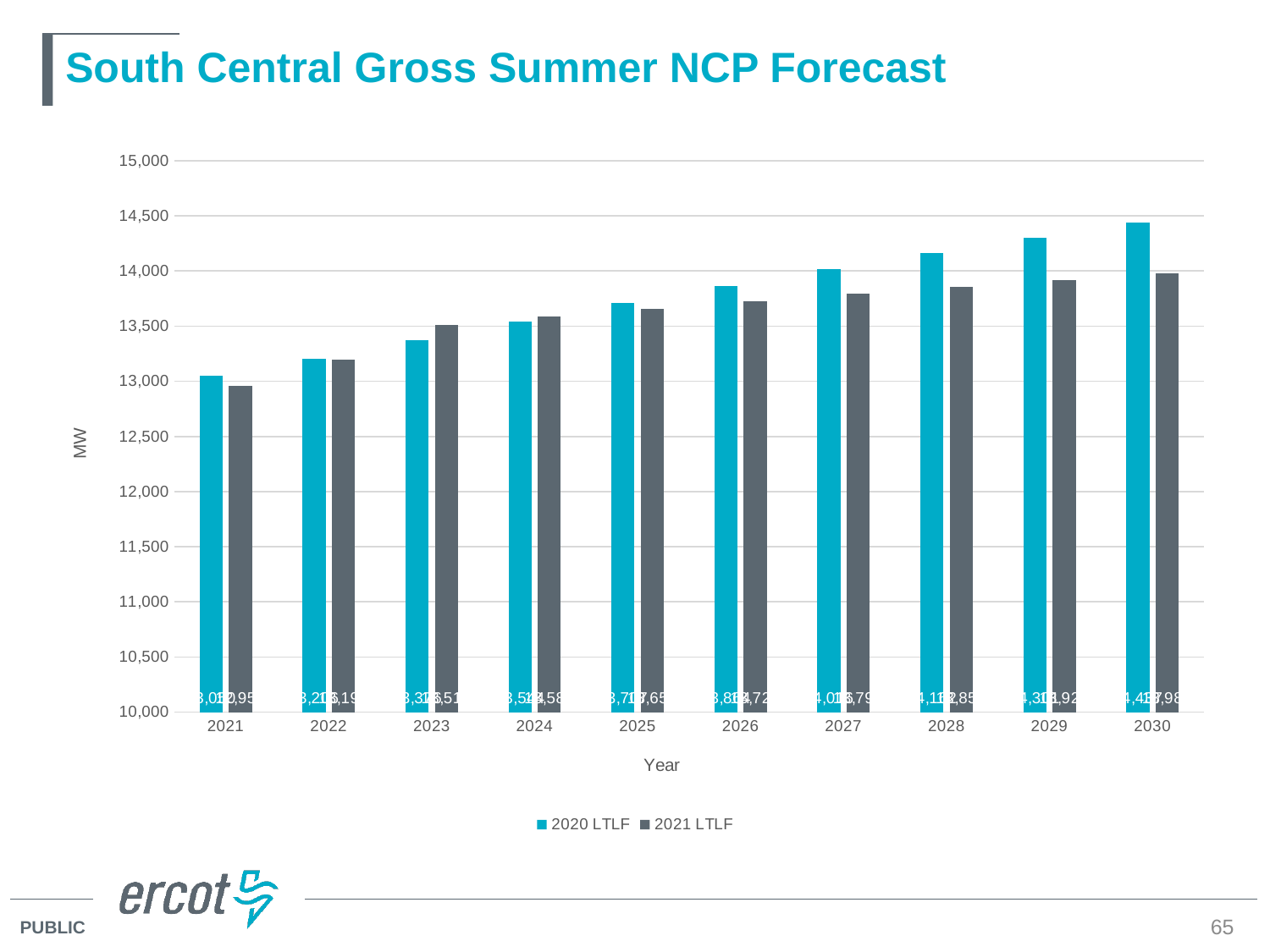
Which year has the lowest 2021 LTLF value? 2021 What is the label on the y axis? MW How many years are shown on the x axis? 10 Which year has the highest 2020 LTLF value? 2030 In 2023, which series has the larger value, 2020 LTLF or 2021 LTLF? 2021 LTLF How many series does the legend list? 2 Is the 2020 LTLF value for 2030 greater or less than 14,000? greater Is the 2020 LTLF value for 2023 greater or less than 13,500? less In 2030, which series has the larger value, 2020 LTLF or 2021 LTLF? 2020 LTLF Is the 2021 LTLF value for 2028 greater or less than 13,500? greater What kind of chart is shown on the slide? bar chart Do the 2020 LTLF values rise or fall from 2021 to 2030? rise